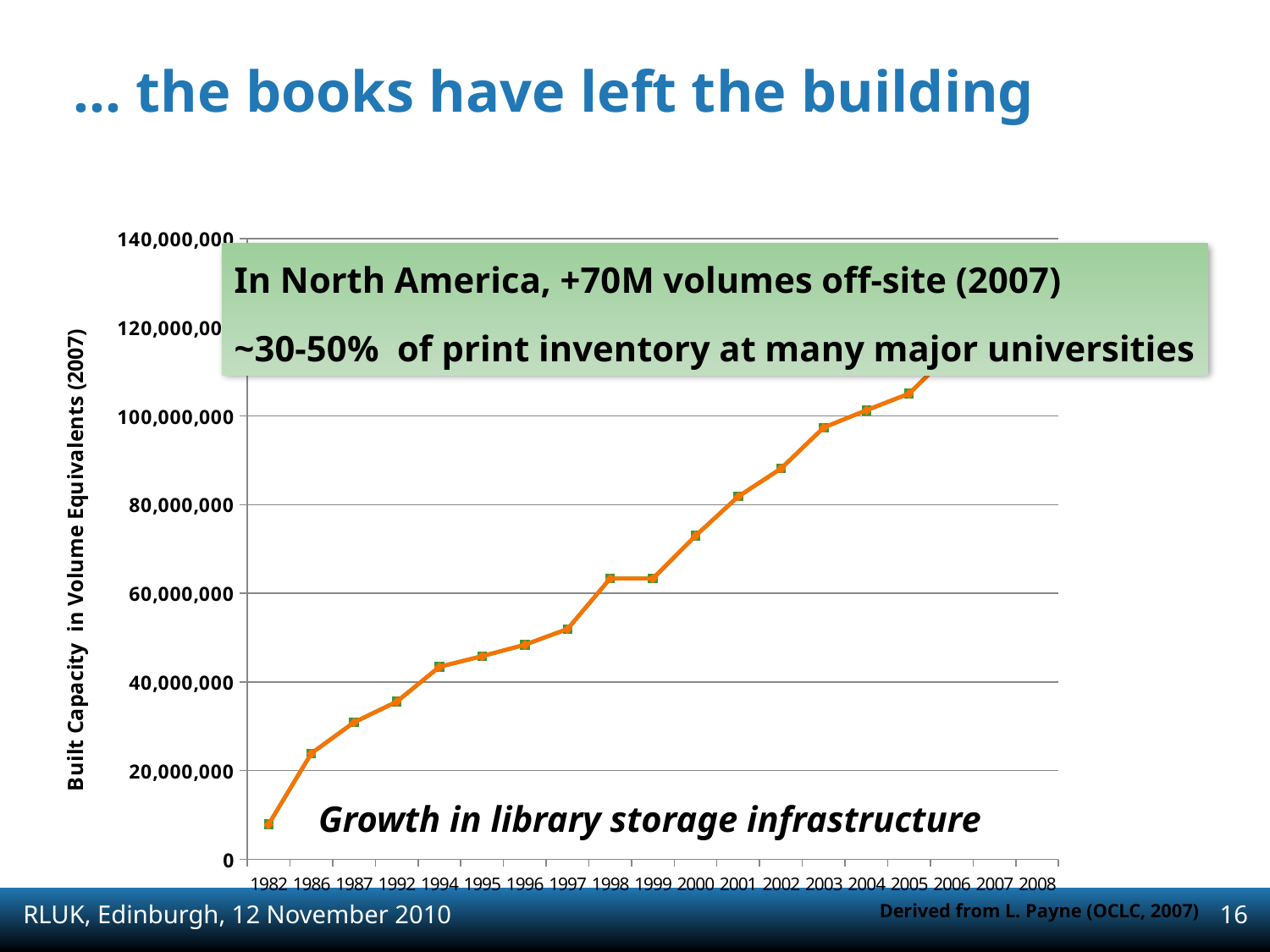
What is the label on the vertical axis of the chart? Built Capacity in Volume Equivalents (2007) What kind of chart is shown on the slide? line chart Which year on the x axis has the lowest plotted value? 1982 Is the value for 2005 greater or less than 100,000,000? greater Is the value for 2000 greater or less than 80,000,000? less Is the value for 1982 greater or less than 20,000,000? less How many year labels are shown on the x axis? 19 Which year has the larger value, 1997 or 2002? 2002 What is the title printed inside the chart area? Growth in library storage infrastructure Do the values rise or fall along the x axis from 1982 to 2005? rise